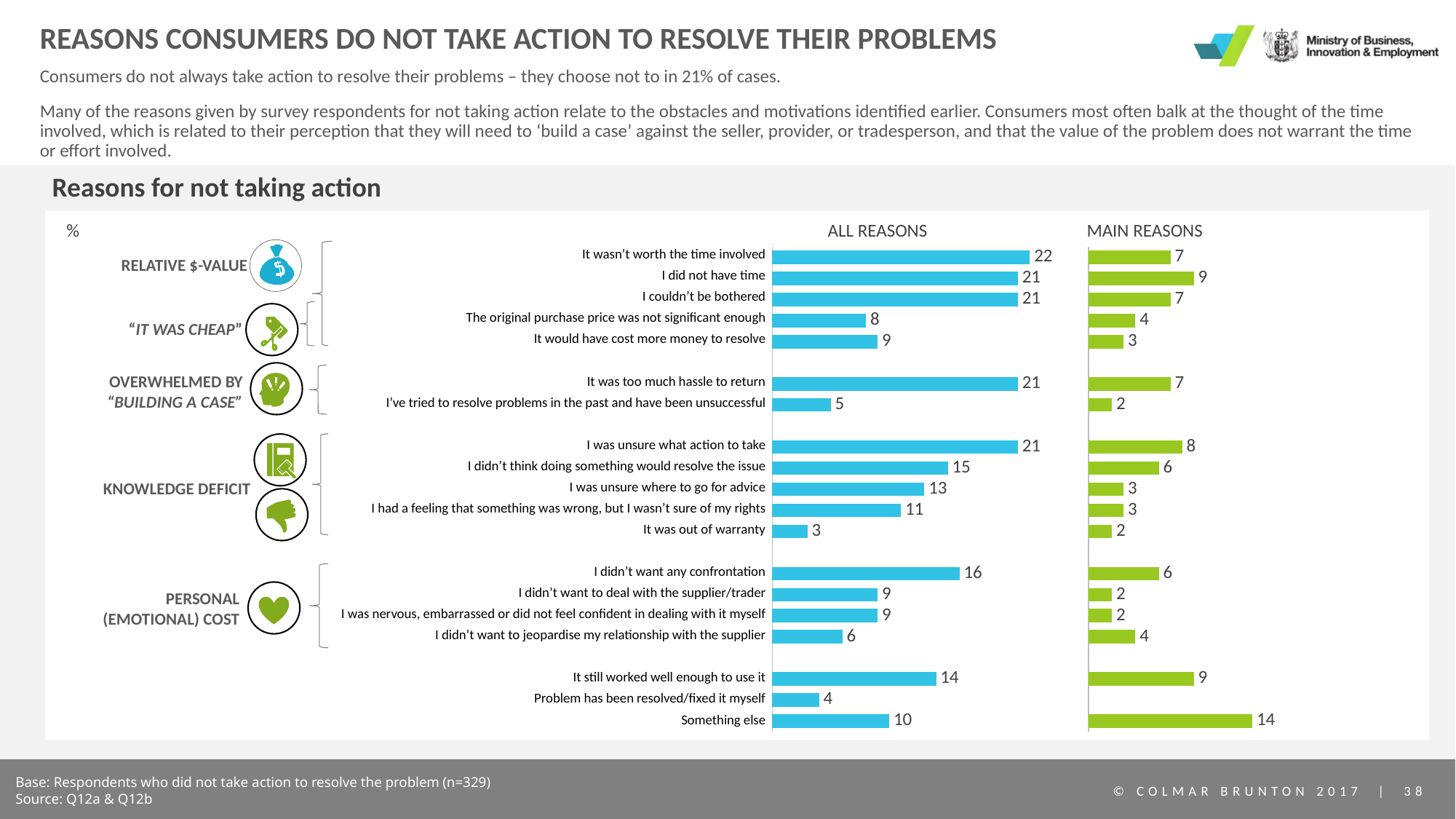
In the MAIN REASONS chart, what is the value for "I did not have time"? 9 In the MAIN REASONS chart, what is the difference between "Something else" and "It still worked well enough to use it"? 5 What type of chart is used for the ALL REASONS and MAIN REASONS data? Bar chart In the MAIN REASONS chart, which reason has the highest value? Something else In the ALL REASONS chart, which is larger: "I was unsure where to go for advice" or "I had a feeling that something was wrong, but I wasn't sure of my rights"? I was unsure where to go for advice In the MAIN REASONS chart, what is the value for "I didn't want to jeopardise my relationship with the supplier"? 4 In the ALL REASONS chart, which reason has the lowest value? It was out of warranty In the ALL REASONS chart, what is the difference between "I didn't want any confrontation" and "I didn't want to jeopardise my relationship with the supplier"? 10 In the ALL REASONS chart, what is the value for "It wasn't worth the time involved"? 22 How many reasons are listed in the ALL REASONS chart? 19 In the ALL REASONS chart, which reason has the highest value? It wasn't worth the time involved In the ALL REASONS chart, what is the value for "I didn't think doing something would resolve the issue"? 15